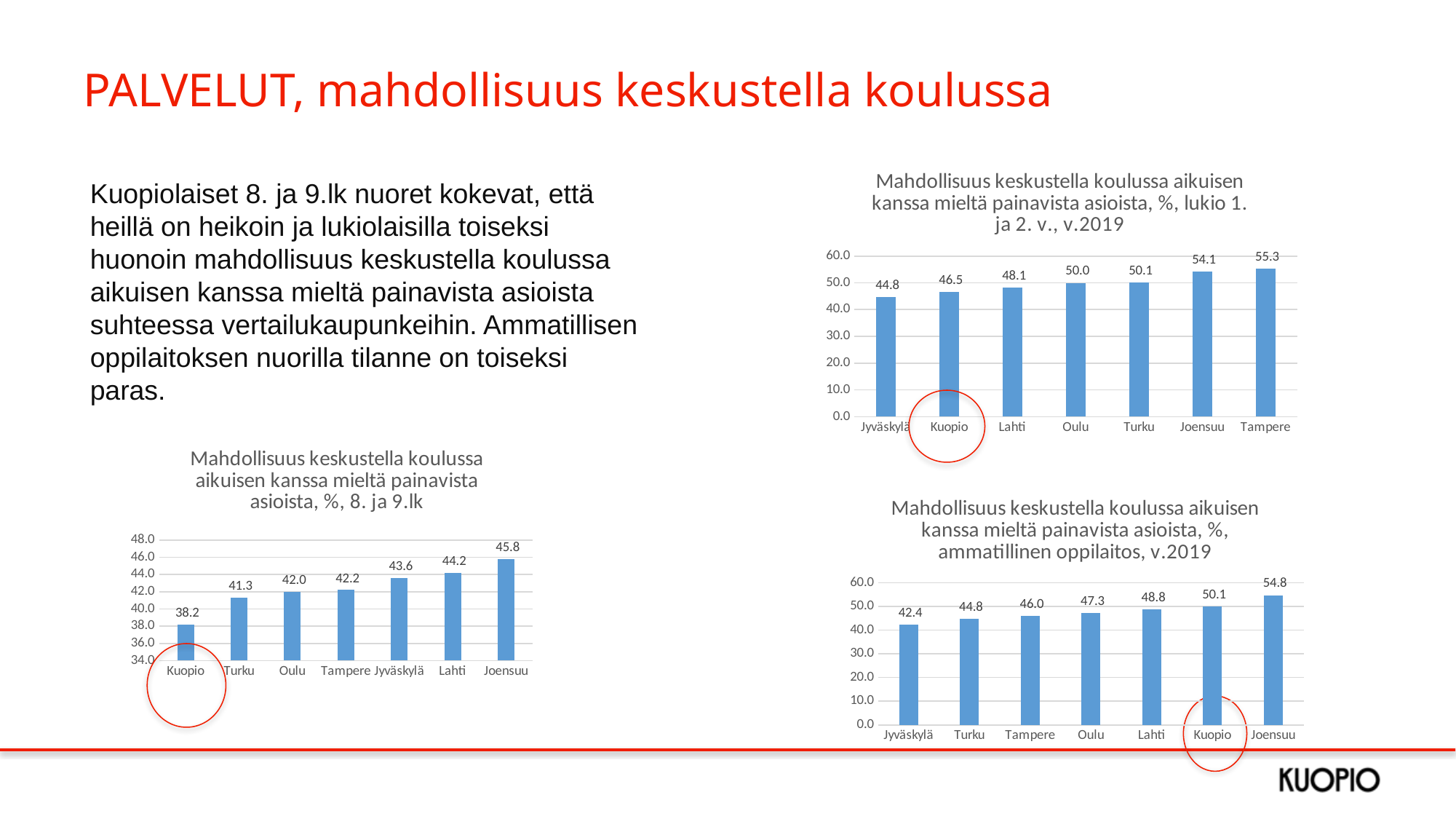
In the bottom-left chart (8. ja 9.lk), what is the value for Kuopio? 38.2 In the top-right chart (lukio 1. ja 2. v.), how many cities are shown? 7 In the bottom-left chart (8. ja 9.lk), what is the difference between Joensuu and Kuopio? 7.6 In the top-right chart (lukio 1. ja 2. v.), which city has the lowest value? Jyväskylä In the bottom-right chart (ammatillinen oppilaitos), what is the difference between Joensuu and Jyväskylä? 12.4 In the bottom-left chart (8. ja 9.lk), which city has the highest value? Joensuu In the bottom-right chart (ammatillinen oppilaitos), which city has the highest value? Joensuu In the top-right chart (lukio 1. ja 2. v.), what is the value for Oulu? 50.0 In the bottom-right chart (ammatillinen oppilaitos), what is the value for Kuopio? 50.1 In the top-right chart (lukio 1. ja 2. v.), which is larger, Lahti or Joensuu? Joensuu What type of chart is the bottom-left chart (8. ja 9.lk)? bar chart In the bottom-right chart (ammatillinen oppilaitos), do the values rise or fall from left to right? rise